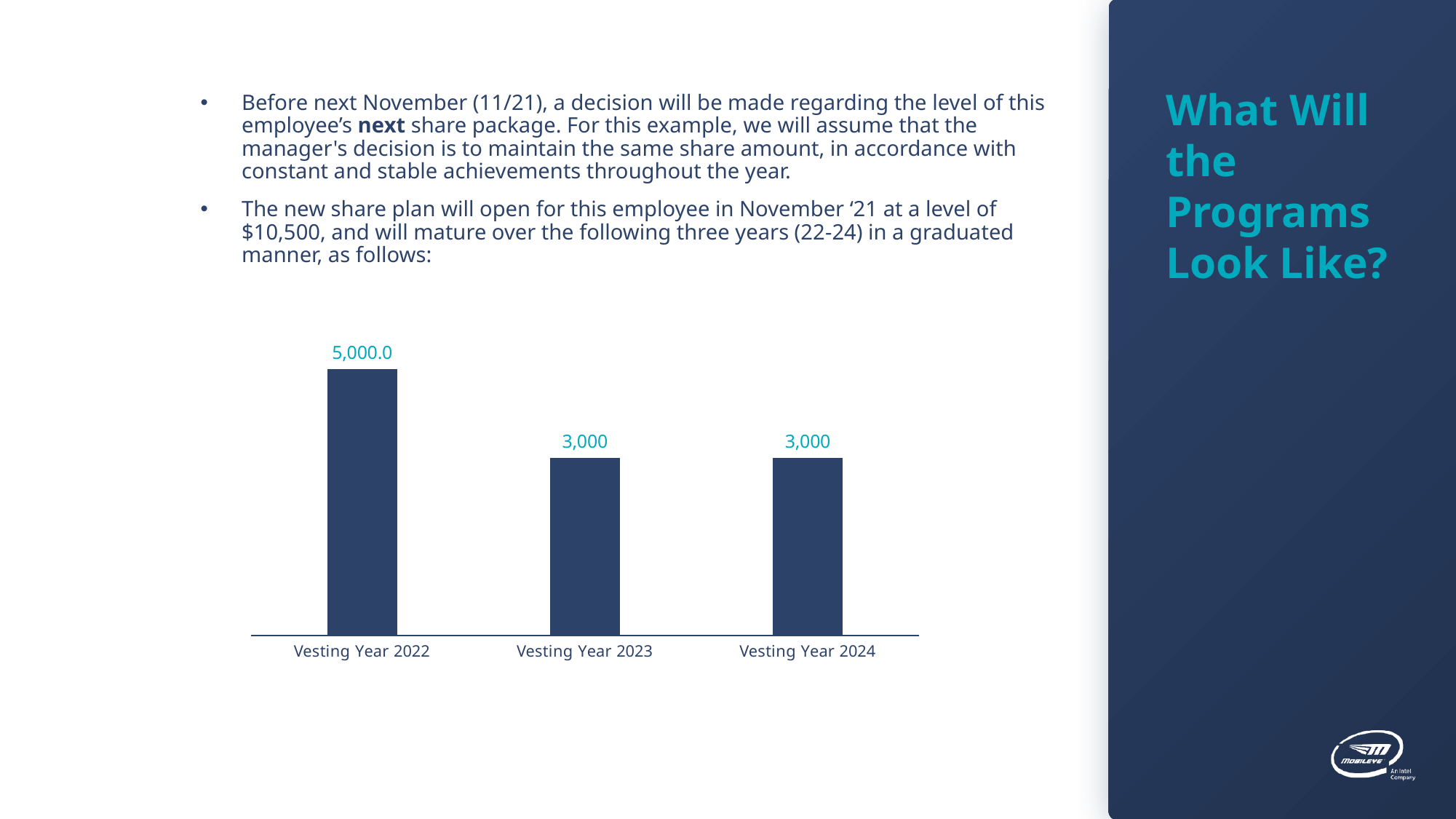
What is the total of the three vesting year values shown on the chart? 11,000 Which is larger, the value for Vesting Year 2022 or Vesting Year 2024? Vesting Year 2022 Do the values rise or fall from Vesting Year 2022 to Vesting Year 2023? Fall Are the values for Vesting Year 2023 and Vesting Year 2024 equal? Yes What kind of chart is shown on the slide? Bar chart How many categories are shown on the chart? 3 What is the difference between the values for Vesting Year 2022 and Vesting Year 2023? 2,000 What is the value for Vesting Year 2023? 3,000 What is the value for Vesting Year 2024? 3,000 What is the value for Vesting Year 2022? 5,000.0 Which vesting year has the highest value? Vesting Year 2022 What is the label of the first category on the x axis? Vesting Year 2022